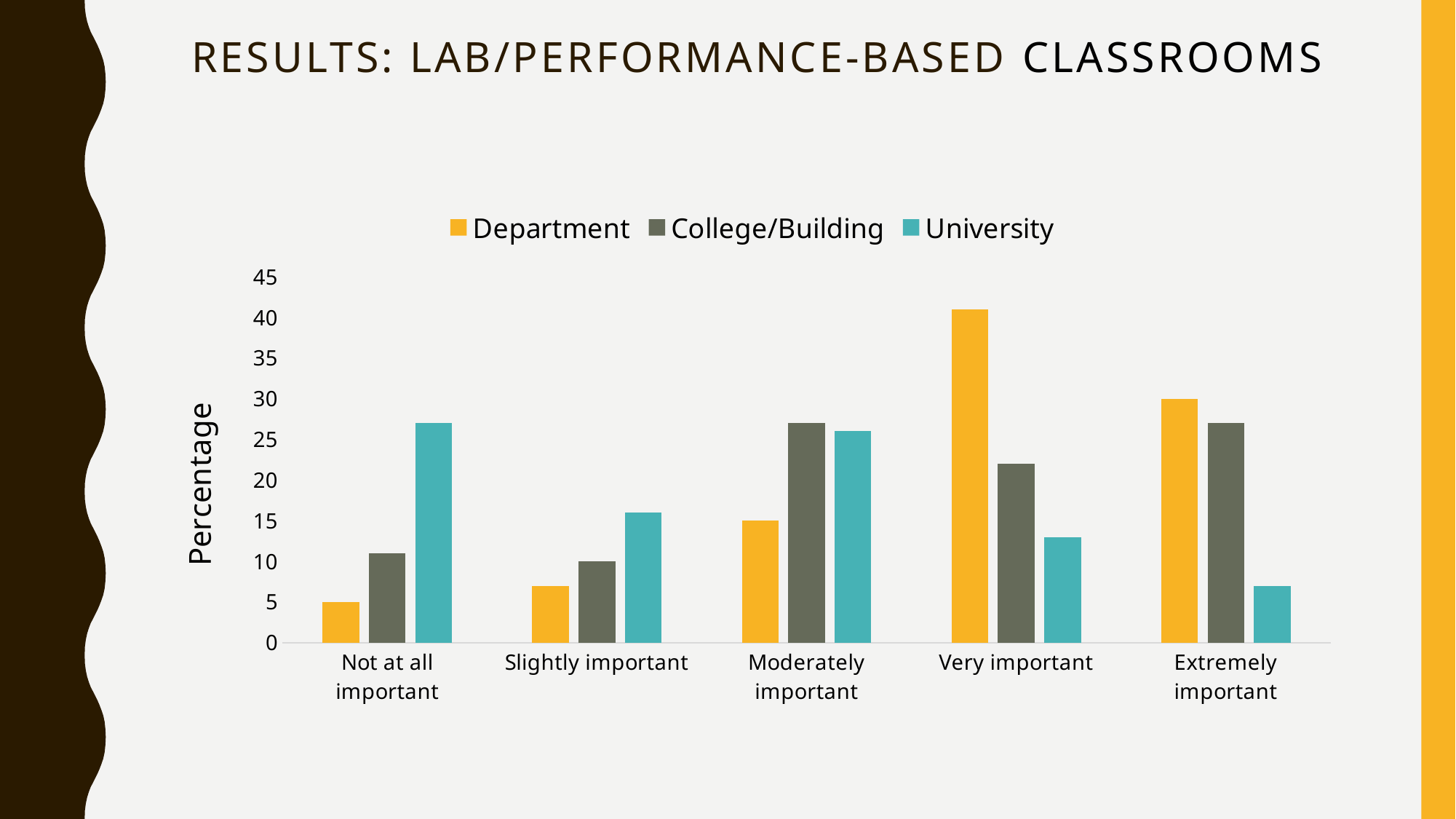
Is the University value for Extremely important greater or less than 10? less What is the label on the vertical axis? Percentage For Not at all important, which is larger: the Department value or the University value? University Does the University series rise or fall from Moderately important to Extremely important? fall Which series is shown in orange in the legend? Department Is the Department value for Very important greater or less than 35? greater What kind of chart is shown on the slide? bar chart Which category has the highest bar in the whole chart? Very important (Department) How many categories are shown on the x axis? 5 For the University series, which category has the lowest value? Extremely important How many series does the legend list? 3 For the Department series, which category has the highest value? Very important